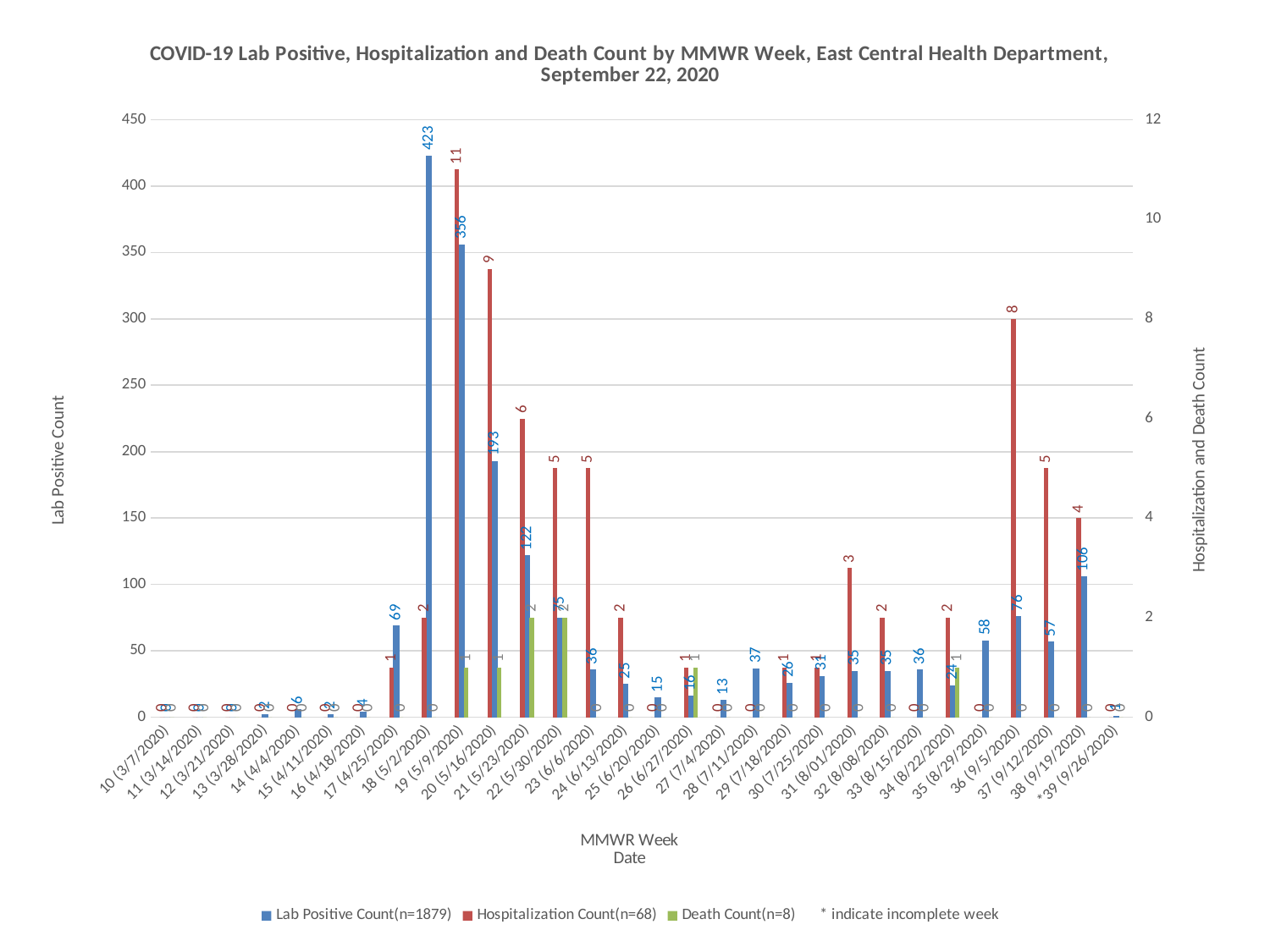
What is the Hospitalization Count for MMWR week 19 (5/9/2020)? 11 How many MMWR weeks are shown on the x axis? 30 What is the Hospitalization Count for MMWR week 36 (9/5/2020)? 8 What is the difference between the Lab Positive Count for week 18 (5/2/2020) and week 19 (5/9/2020)? 67 What is the Lab Positive Count for MMWR week 38 (9/19/2020)? 106 Which is larger, the Lab Positive Count for week 36 (9/5/2020) or for week 35 (8/29/2020)? week 36 (9/5/2020) Which MMWR week has the highest Lab Positive Count? 18 (5/2/2020) What type of chart is shown on the slide? bar chart Which MMWR week has the highest Hospitalization Count? 19 (5/9/2020) What is the Lab Positive Count for MMWR week 18 (5/2/2020)? 423 How many series does the legend list? 3 What does the asterisk on week 39 indicate, according to the legend note? incomplete week